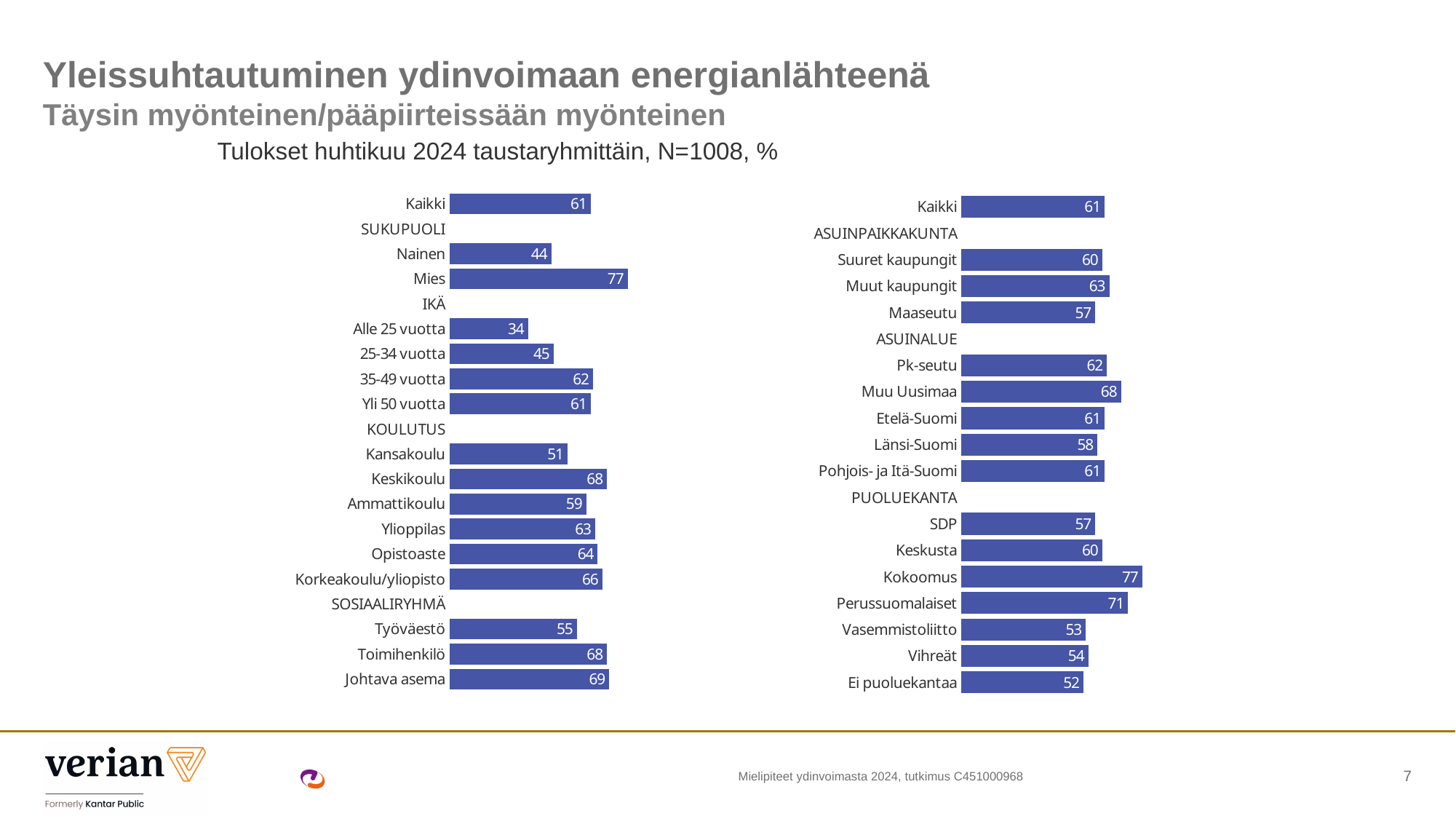
In the right chart, which category has the highest value? Kokoomus In the right chart, what is the value for Perussuomalaiset? 71 In the left chart, what is the value for Mies? 77 In the right chart, which is larger, the value for Maaseutu or the value for Muut kaupungit? Muut kaupungit In the left chart, which category has the lowest value? Alle 25 vuotta In the right chart, what is the difference between the values for Kokoomus and Ei puoluekantaa? 25 In the left chart, what is the value for Alle 25 vuotta? 34 In the left chart, which is larger, the value for Kansakoulu or the value for Keskikoulu? Keskikoulu In the left chart, do the values rise or fall across the age groups from Alle 25 vuotta to 35-49 vuotta? Rise What kind of chart is shown on the left of the slide? Bar chart In the right chart, what is the value for Muu Uusimaa? 68 In the left chart, what is the difference between the values for Mies and Nainen? 33